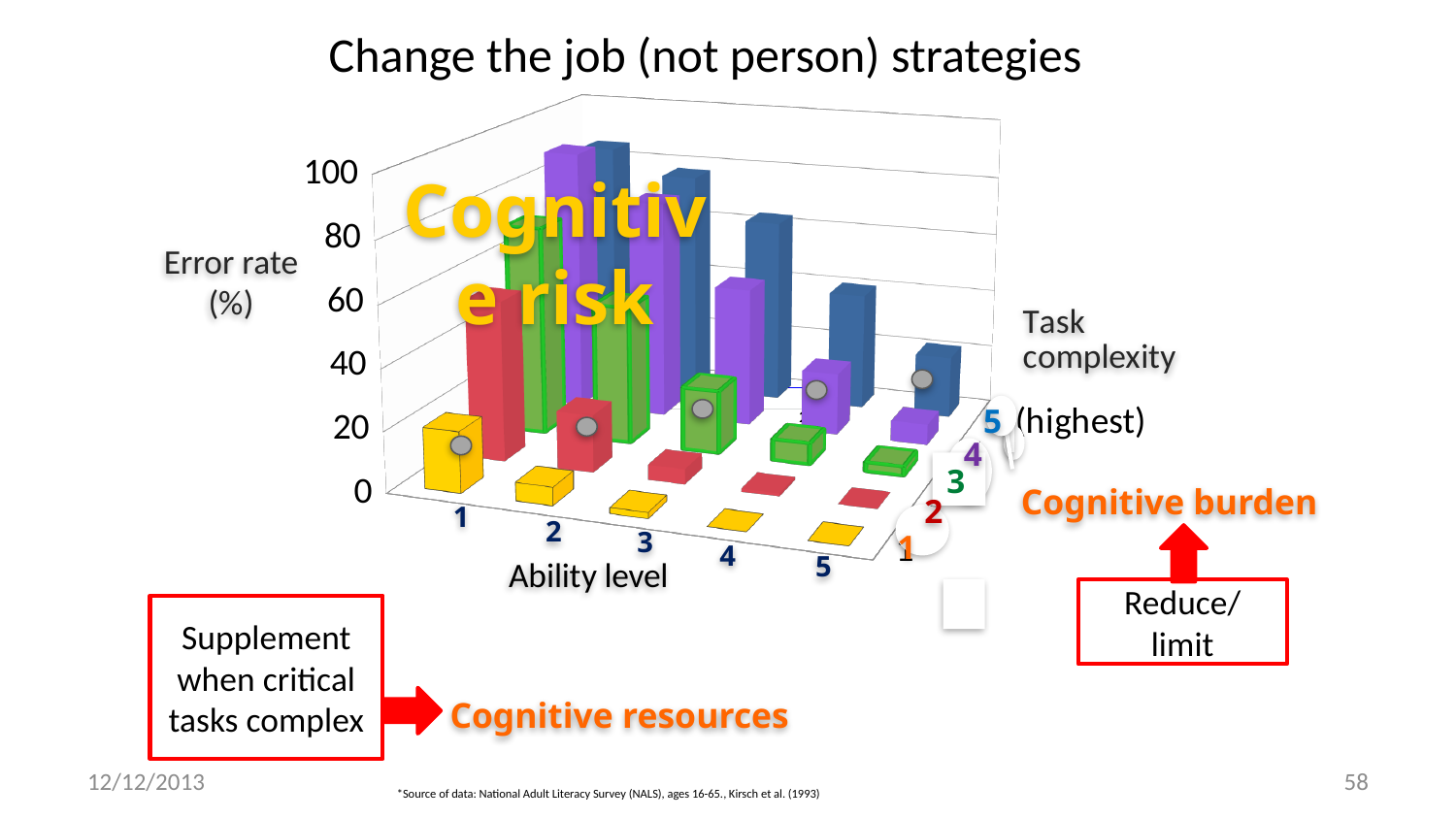
What kind of chart is shown on the slide? 3D bar chart Is the error rate for ability level 5 at task complexity 1 greater or less than 20? less What is the label of the horizontal axis of the chart? Ability level Is the error rate for ability level 1 at task complexity 5 greater or less than 60? greater For a given ability level, does the error rate rise or fall as task complexity increases from 1 to 5? rise Which task complexity level is labelled as the highest? 5 As ability level increases from 1 to 5, does the error rate rise or fall? fall How many task complexity levels are shown in the chart? 5 What is the label of the vertical axis of the chart? Error rate (%) How many ability levels are shown along the x axis of the chart? 5 Which ability level has the highest error rate at task complexity 5? 1